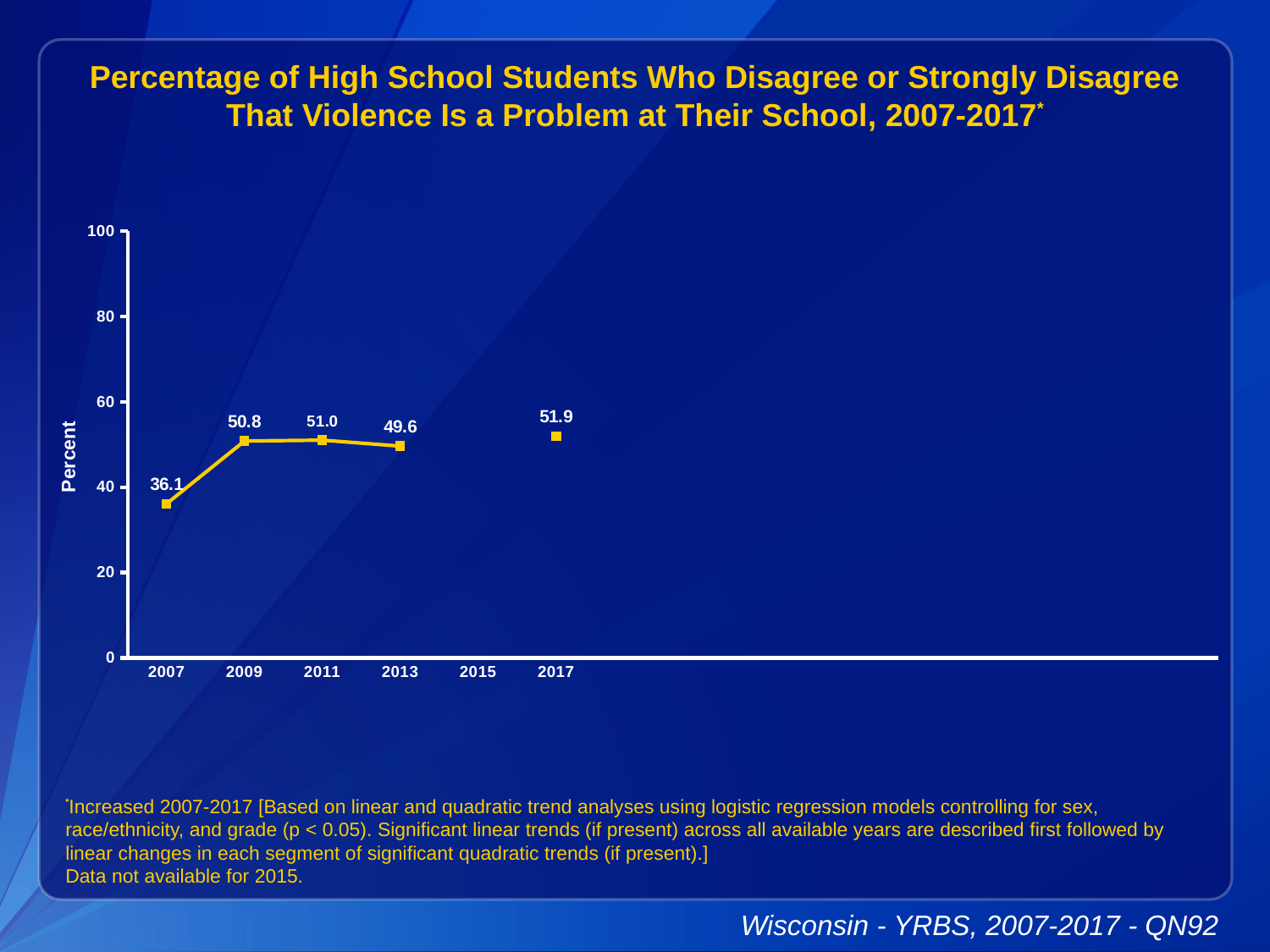
Which year has the highest value? 2017 What is the value for 2007? 36.1 Which is larger, the value for 2011 or the value for 2013? 2011 What is the difference between the values for 2009 and 2007? 14.7 What kind of chart is this? line chart Which year on the x axis has no data shown? 2015 What is the value for 2017? 51.9 Does the value rise or fall from 2007 to 2009? rise What is the value for 2013? 49.6 Which year has the lowest value? 2007 How many years have a plotted data point? 5 Is the value for 2007 greater or less than 40? less